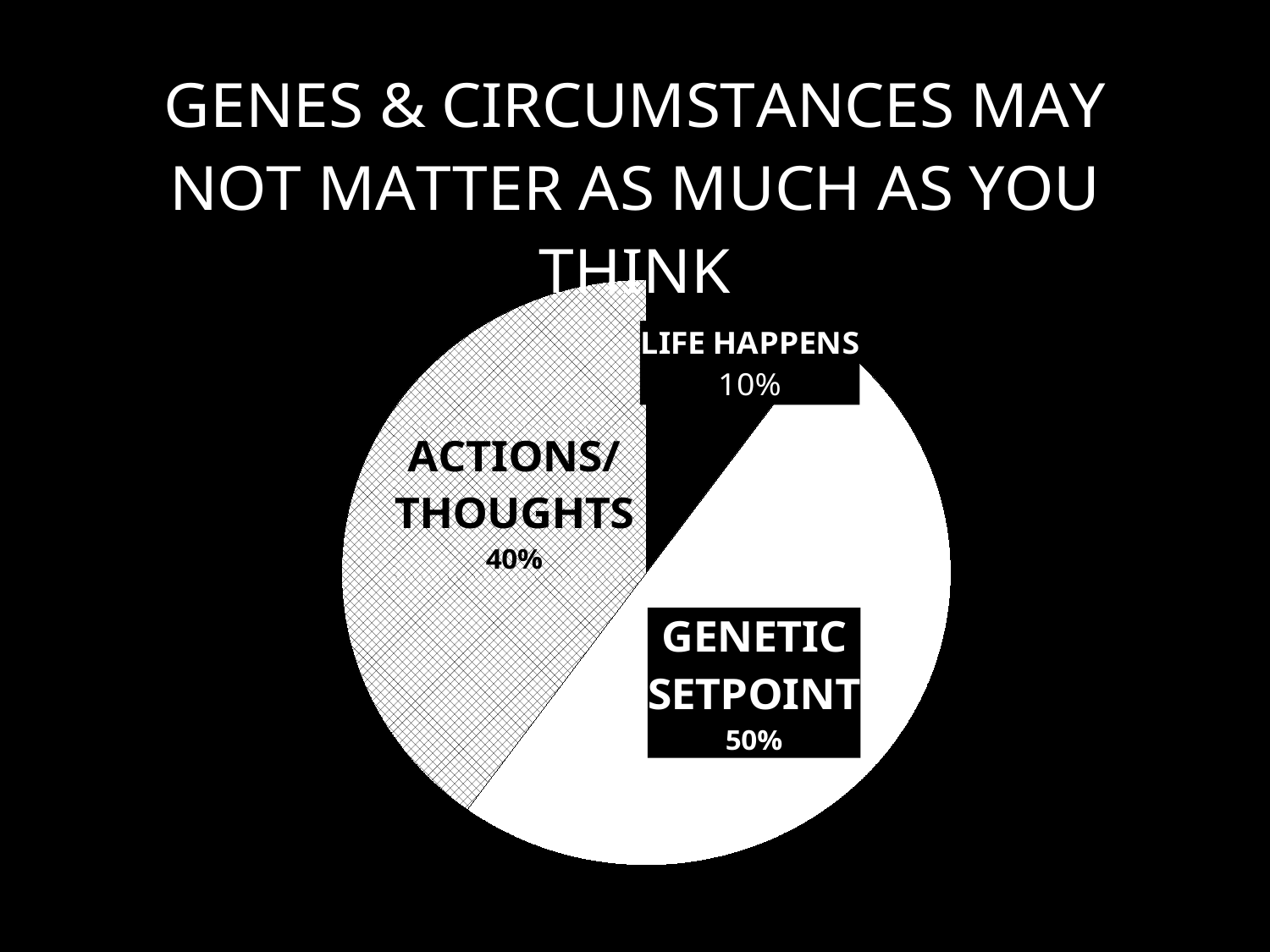
Which slice of the pie is the largest? GENETIC SETPOINT What percentage is shown for GENETIC SETPOINT? 50% What percentage is shown for ACTIONS/THOUGHTS? 40% Which slice of the pie is the smallest? LIFE HAPPENS How many slices does the pie chart have? 3 What kind of chart is shown on the slide? pie chart Which is larger, ACTIONS/THOUGHTS or LIFE HAPPENS? ACTIONS/THOUGHTS What is the difference between the ACTIONS/THOUGHTS and LIFE HAPPENS percentages? 30% What is the title of the slide containing the pie chart? GENES & CIRCUMSTANCES MAY NOT MATTER AS MUCH AS YOU THINK What percentage is shown for LIFE HAPPENS? 10% What share of the pie does GENETIC SETPOINT take? 50% What is the difference between the GENETIC SETPOINT and ACTIONS/THOUGHTS percentages? 10%